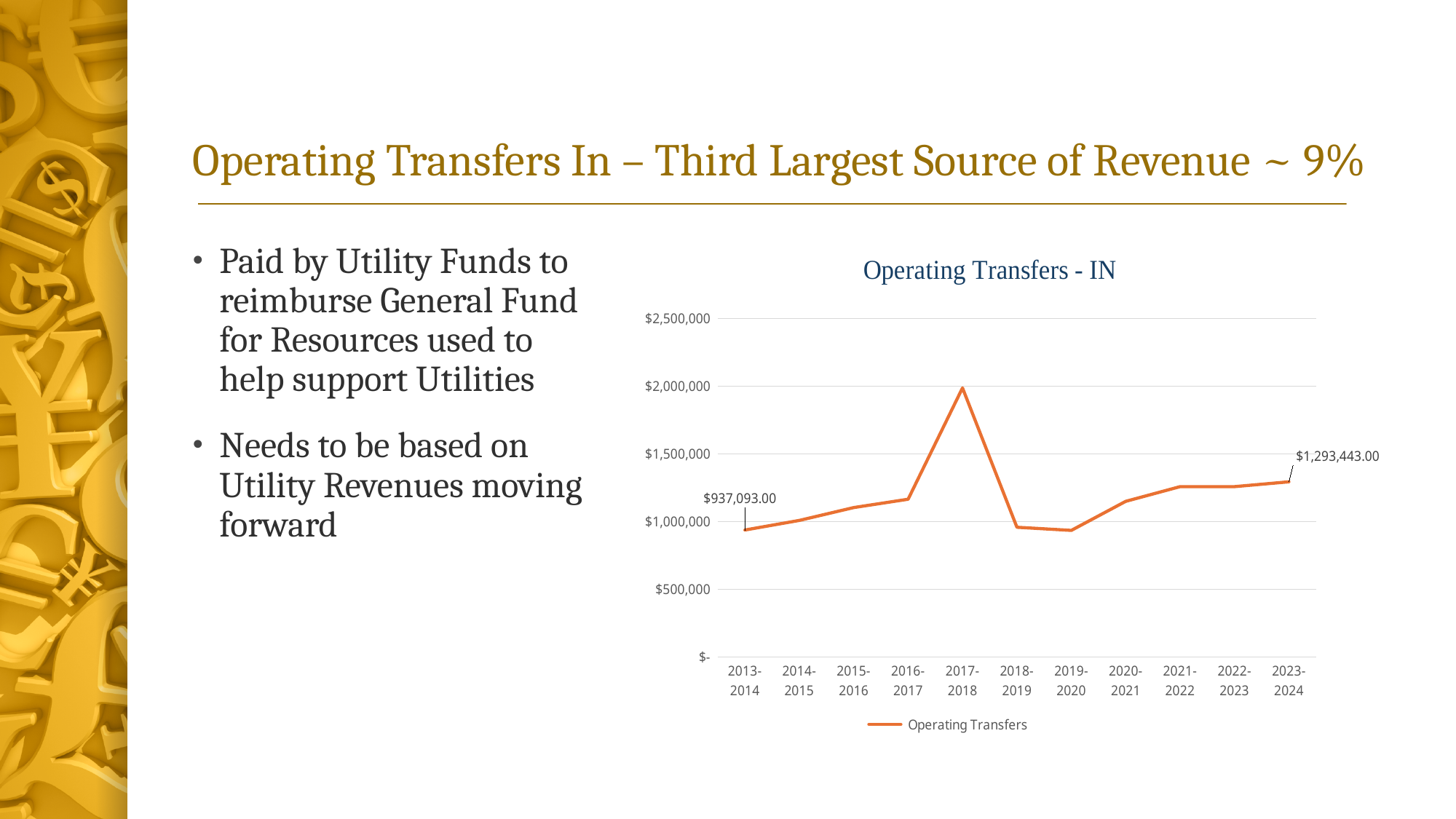
What is the title of the chart? Operating Transfers - IN How many series does the legend list? 1 What type of chart is shown on the slide? line chart What is the value of Operating Transfers for 2023-2024? $1,293,443.00 Is the value for 2017-2018 greater or less than $1,500,000? greater Which is larger, the value for 2016-2017 or the value for 2017-2018? 2017-2018 What is the difference between the 2023-2024 value and the 2013-2014 value? $356,350.00 Which fiscal year has the highest value of Operating Transfers? 2017-2018 How many fiscal years are plotted on the x axis? 11 What is the value of Operating Transfers for 2013-2014? $937,093.00 Do the values rise or fall from 2013-2014 to 2016-2017? rise